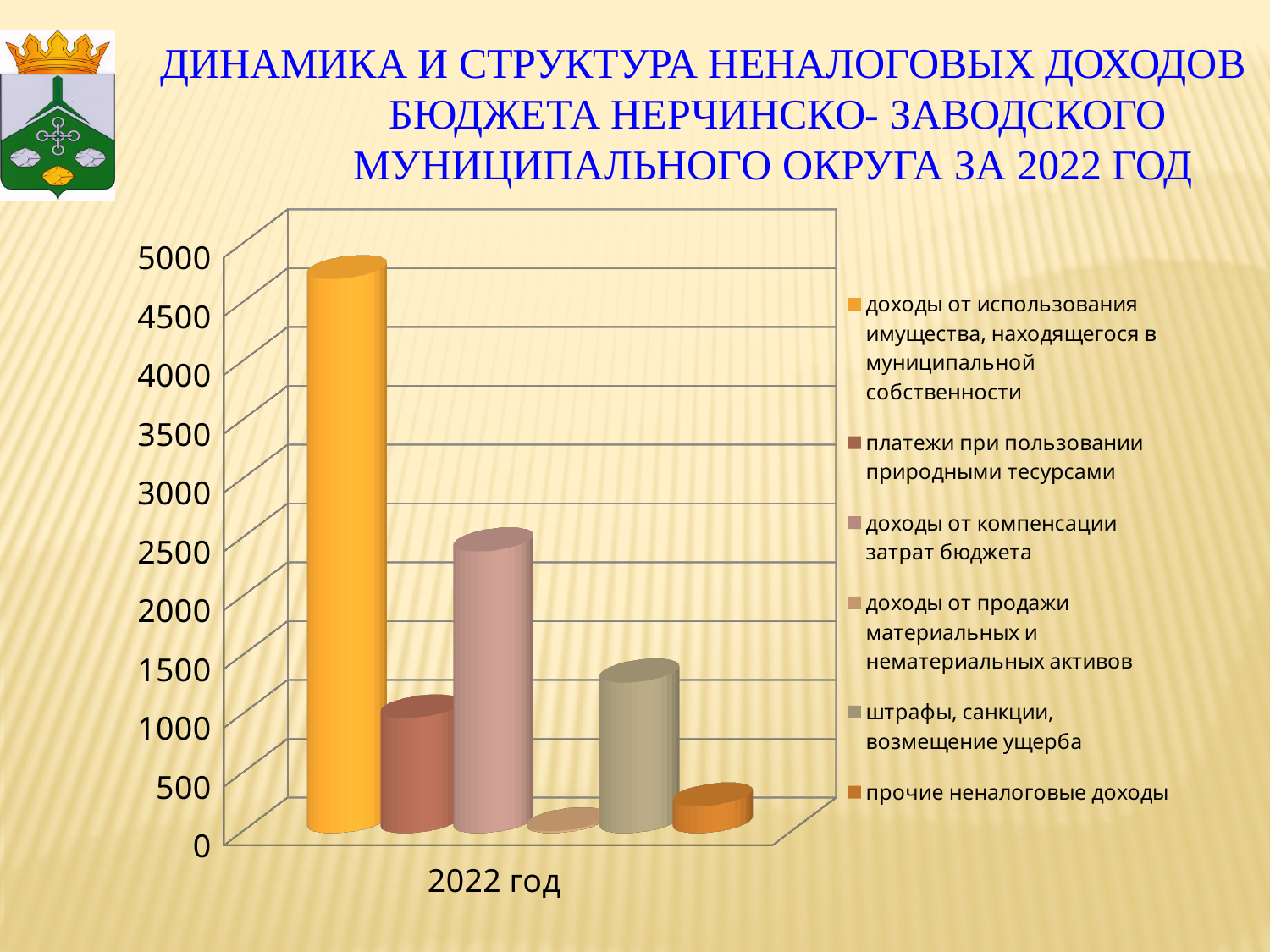
Is the value for прочие неналоговые доходы greater or less than 500? less Which is larger: штрафы, санкции, возмещение ущерба or прочие неналоговые доходы? штрафы, санкции, возмещение ущерба How many series does the legend list? 6 What kind of chart is shown on the slide? bar chart Is the value for доходы от компенсации затрат бюджета greater or less than 2000? greater What is the category label on the x axis? 2022 год Is the value for платежи при пользовании природными тесурсами greater or less than 1500? less Which is larger: доходы от компенсации затрат бюджета or штрафы, санкции, возмещение ущерба? доходы от компенсации затрат бюджета How many categories are shown on the x axis? 1 Which series has the lowest value in 2022? доходы от продажи материальных и нематериальных активов Which series has the highest value in 2022? доходы от использования имущества, находящегося в муниципальной собственности